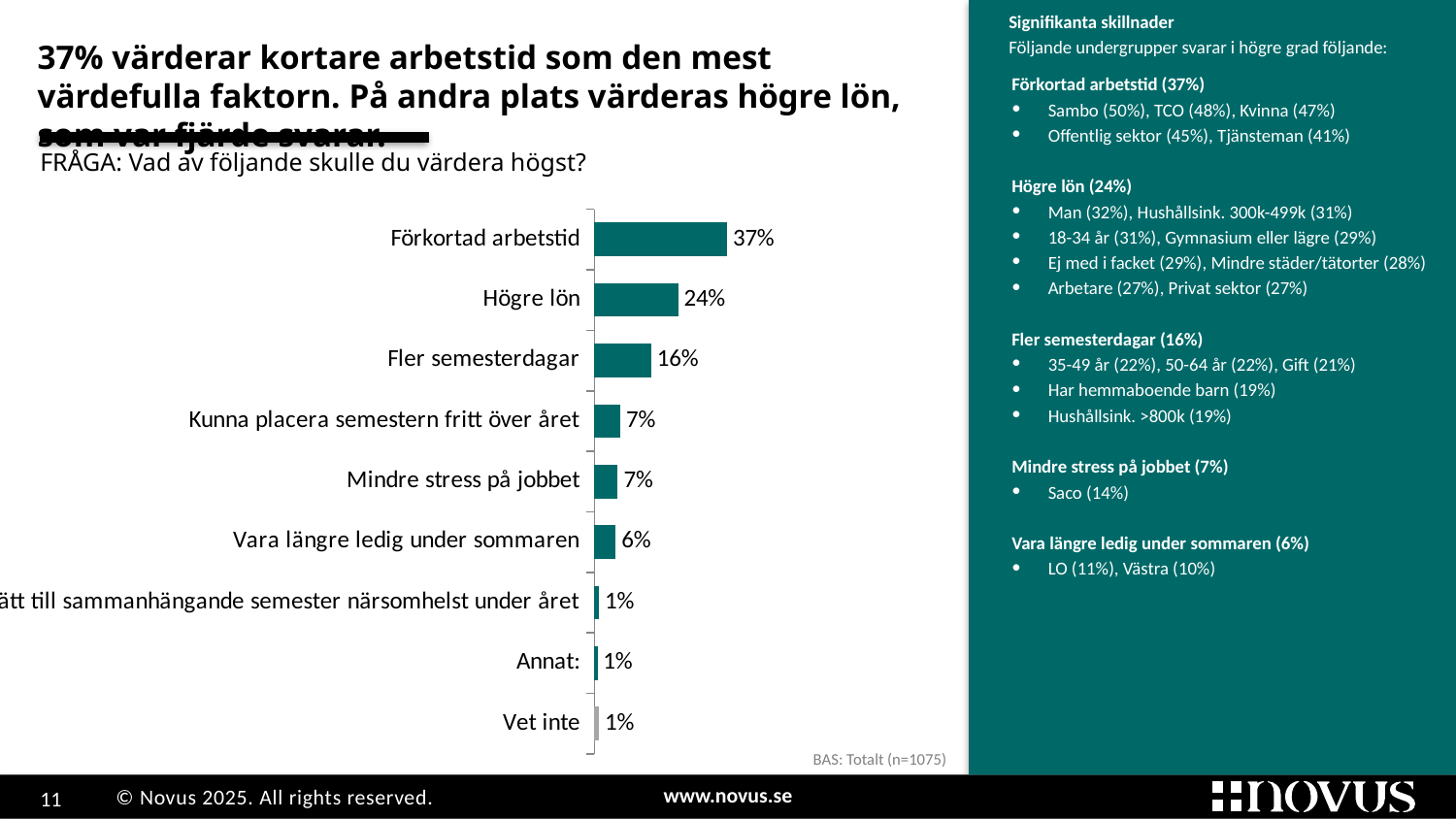
What kind of chart is shown on the slide? Bar chart What value is shown for Vara längre ledig under sommaren? 6% What value is shown for Förkortad arbetstid? 37% What is the difference between the values for Förkortad arbetstid and Högre lön? 13 percentage points What is the base (BAS) noted below the chart? Totalt (n=1075) What value is shown for Fler semesterdagar? 16% What value is shown for Vet inte? 1% What value is shown for Högre lön? 24% Which is larger, the value for Mindre stress på jobbet or the value for Vara längre ledig under sommaren? Mindre stress på jobbet Which category has the highest value? Förkortad arbetstid What is the difference between the values for Högre lön and Fler semesterdagar? 8 percentage points How many categories are shown in the chart? 9